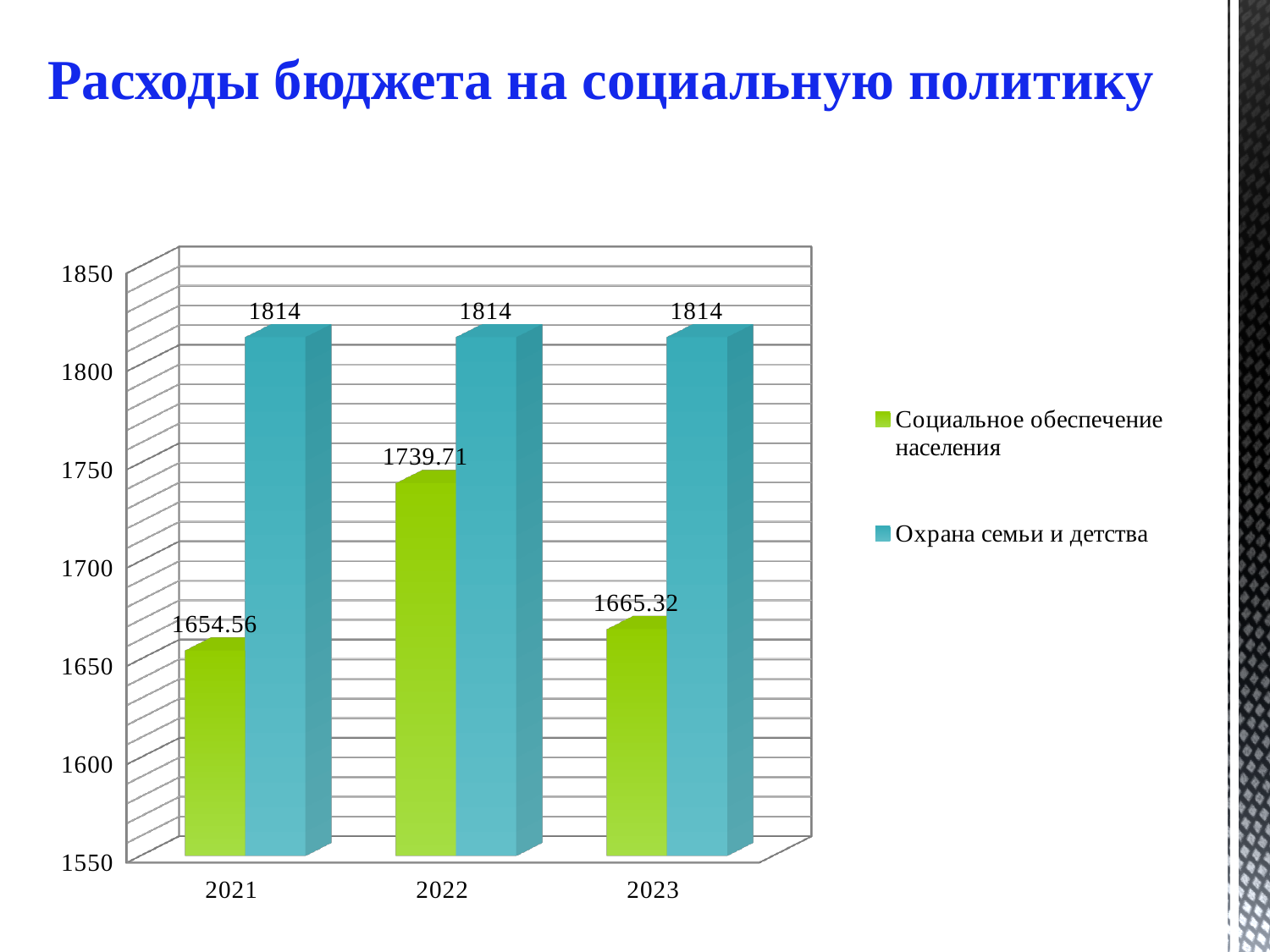
How many years are shown on the x axis? 3 What is the value for Охрана семьи и детства in 2023? 1814 What is the value for Социальное обеспечение населения in 2021? 1654.56 What is the title of the slide? Расходы бюджета на социальную политику In which year is the value for Социальное обеспечение населения lowest? 2021 What is the difference between the Социальное обеспечение населения values for 2022 and 2021? 85.15 In which year is the value for Социальное обеспечение населения highest? 2022 What is the value for Социальное обеспечение населения in 2022? 1739.71 What kind of chart is shown on the slide? Bar chart Which series has the larger value in 2022, Социальное обеспечение населения or Охрана семьи и детства? Охрана семьи и детства What is the difference between Охрана семьи и детства and Социальное обеспечение населения in 2023? 148.68 How many series does the legend list? 2